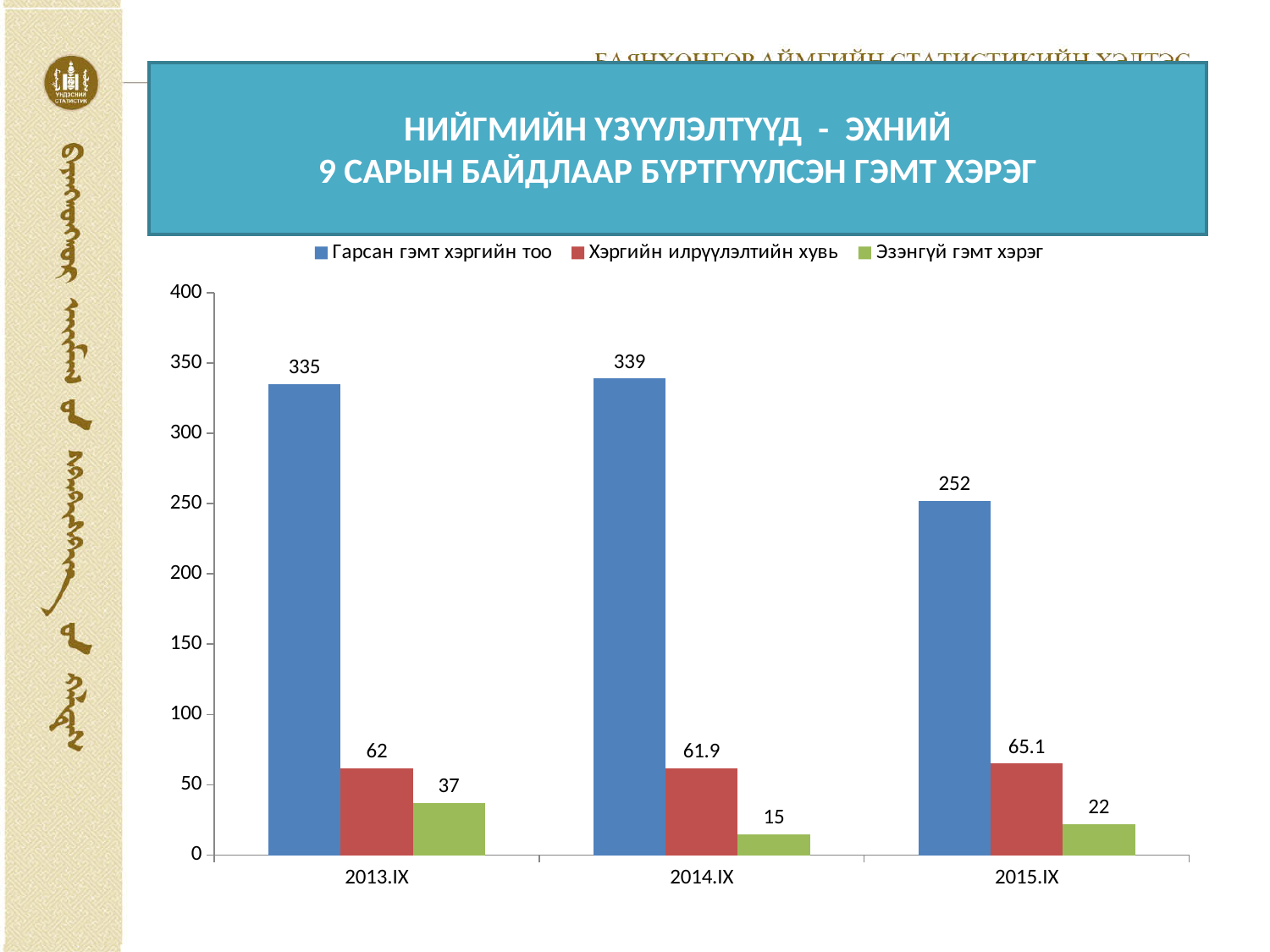
Which colour represents Хэргийн илрүүлэлтийн хувь in the legend? red In which period is Эзэнгүй гэмт хэрэг the lowest? 2014.IX What is the value of Гарсан гэмт хэргийн тоо for 2013.IX? 335 In which period is Гарсан гэмт хэргийн тоо the highest? 2014.IX Is the value of Гарсан гэмт хэргийн тоо for 2015.IX greater or less than 300? less How many periods are shown on the x axis? 3 What is the value of Хэргийн илрүүлэлтийн хувь for 2014.IX? 61.9 What kind of chart is shown on the slide? bar chart How many series does the legend list? 3 Which is larger: Эзэнгүй гэмт хэрэг in 2013.IX or in 2015.IX? 2013.IX What is the difference between Гарсан гэмт хэргийн тоо in 2014.IX and 2015.IX? 87 What is the value of Эзэнгүй гэмт хэрэг for 2015.IX? 22